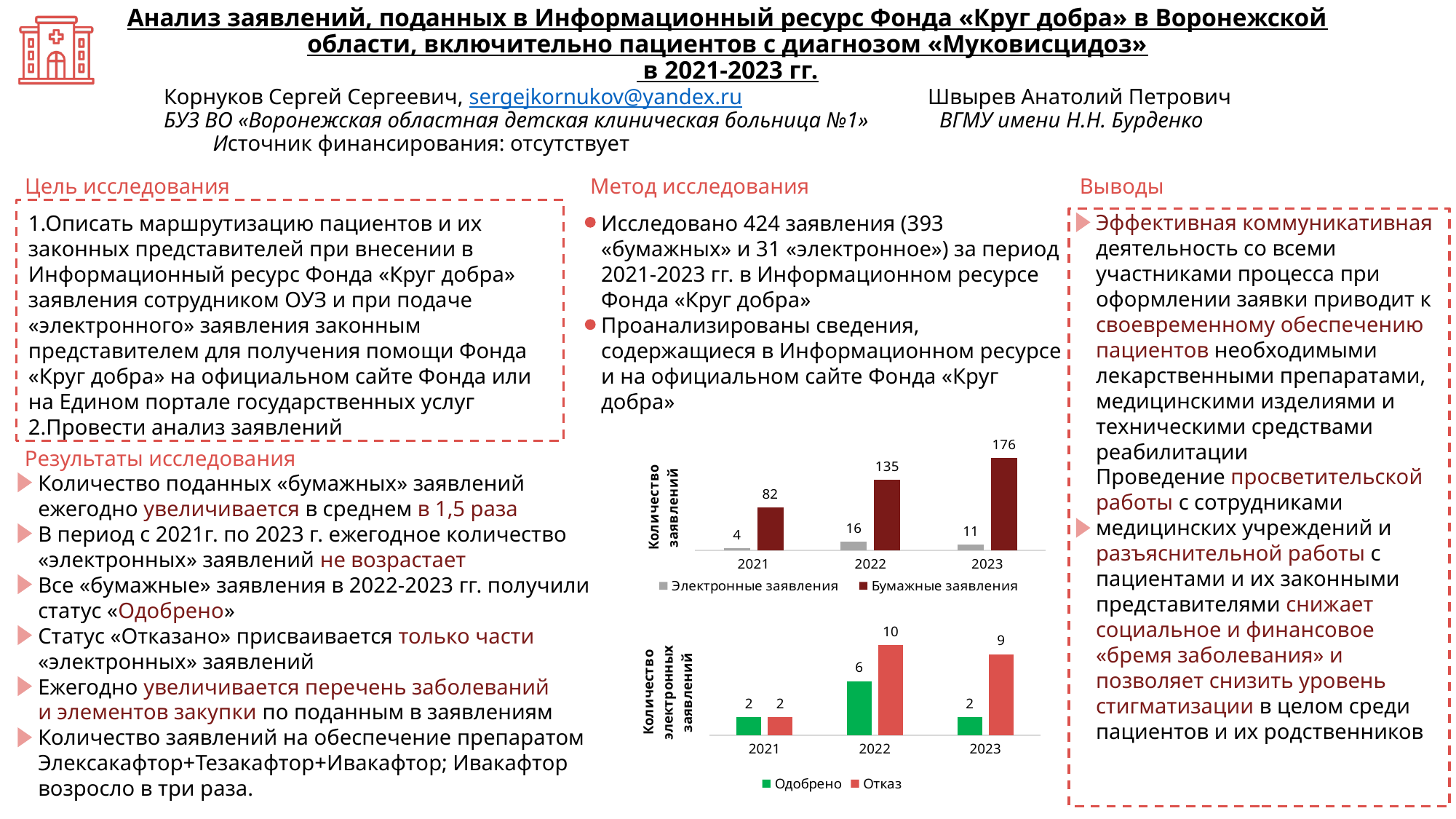
In the top chart, which year has the lowest value for Электронные заявления? 2021 In the top chart, what is the value for Бумажные заявления in 2023? 176 What kind of chart is the bottom chart? bar chart In the top chart, what is the difference between Бумажные заявления in 2023 and in 2022? 41 In the top chart, what is the value for Электронные заявления in 2022? 16 In the top chart, do the values for Бумажные заявления rise or fall from 2021 to 2023? rise In the bottom chart, what is the difference between Отказ and Одобрено in 2023? 7 In the top chart, which year has the highest value for Бумажные заявления? 2023 How many series does the legend of the top chart list? 2 In the bottom chart, what is the value for Отказ in 2022? 10 How many years are shown on the x axis of the bottom chart? 3 In the bottom chart, which is larger in 2023: Одобрено or Отказ? Отказ